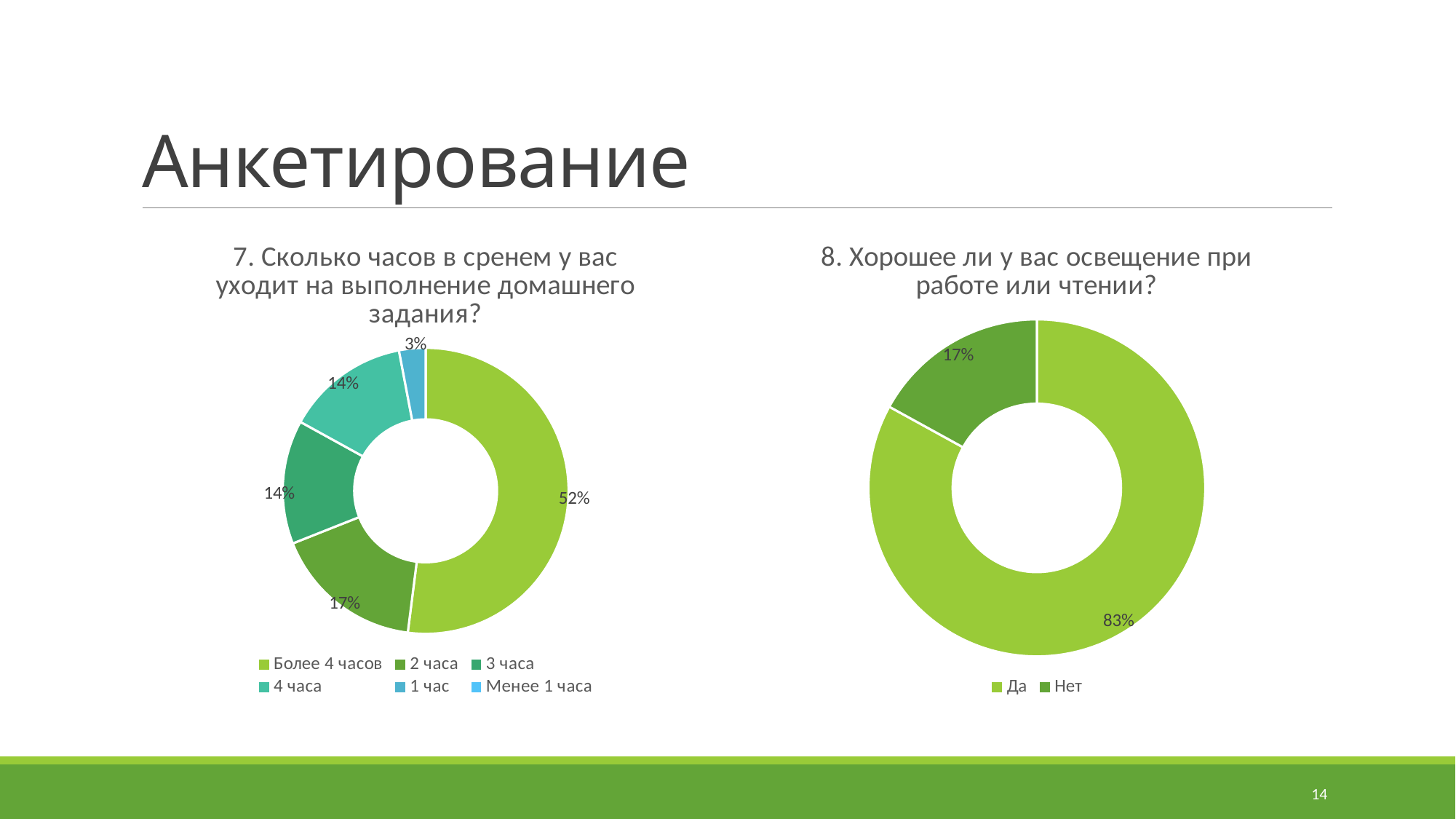
In the left chart (question 7), what share of respondents answered 'Более 4 часов'? 52% In the right chart (question 8), what share of respondents answered 'Да'? 83% In the left chart (question 7), what share of respondents answered '1 час'? 3% In the left chart (question 7), which answer has the largest share? Более 4 часов In the right chart (question 8), what share of respondents answered 'Нет'? 17% In the right chart (question 8), what is the difference between the shares for 'Да' and 'Нет'? 66% In the left chart (question 7), which is larger: the share for '2 часа' or the share for '1 час'? 2 часа In the left chart (question 7), what is the difference between the shares for 'Более 4 часов' and '2 часа'? 35% In the left chart (question 7), what share of respondents answered '2 часа'? 17% In the right chart (question 8), how many entries does the legend list? 2 In the left chart (question 7), how many entries does the legend list? 6 What type of chart is used for question 7 on the left? Doughnut (pie) chart